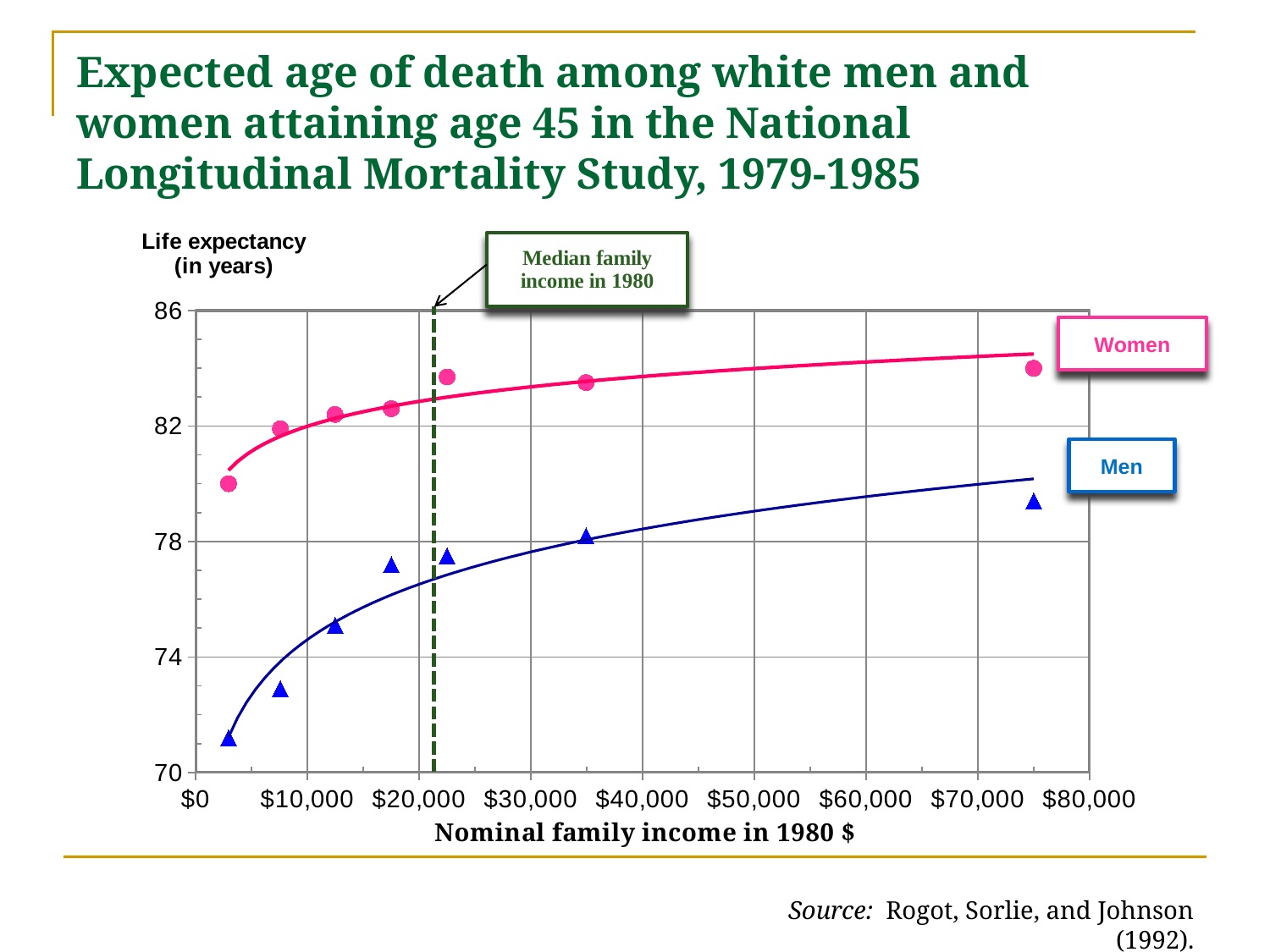
How many series does the chart show? 2 Is the life expectancy for the highest-income Men data point greater or less than 82? less Is the life expectancy for the highest-income Women data point greater or less than 82? greater What is the label of the x axis? Nominal family income in 1980 $ Does life expectancy rise or fall as nominal family income increases? rise Is the life expectancy for the lowest-income Men data point greater or less than 74? less How many data points are plotted for the Men series? 7 What does the vertical dashed line on the chart mark? Median family income in 1980 What kind of chart is shown on the slide? scatter chart How many data points are plotted for the Women series? 7 Which series has the higher life expectancy at every income level, Women or Men? Women